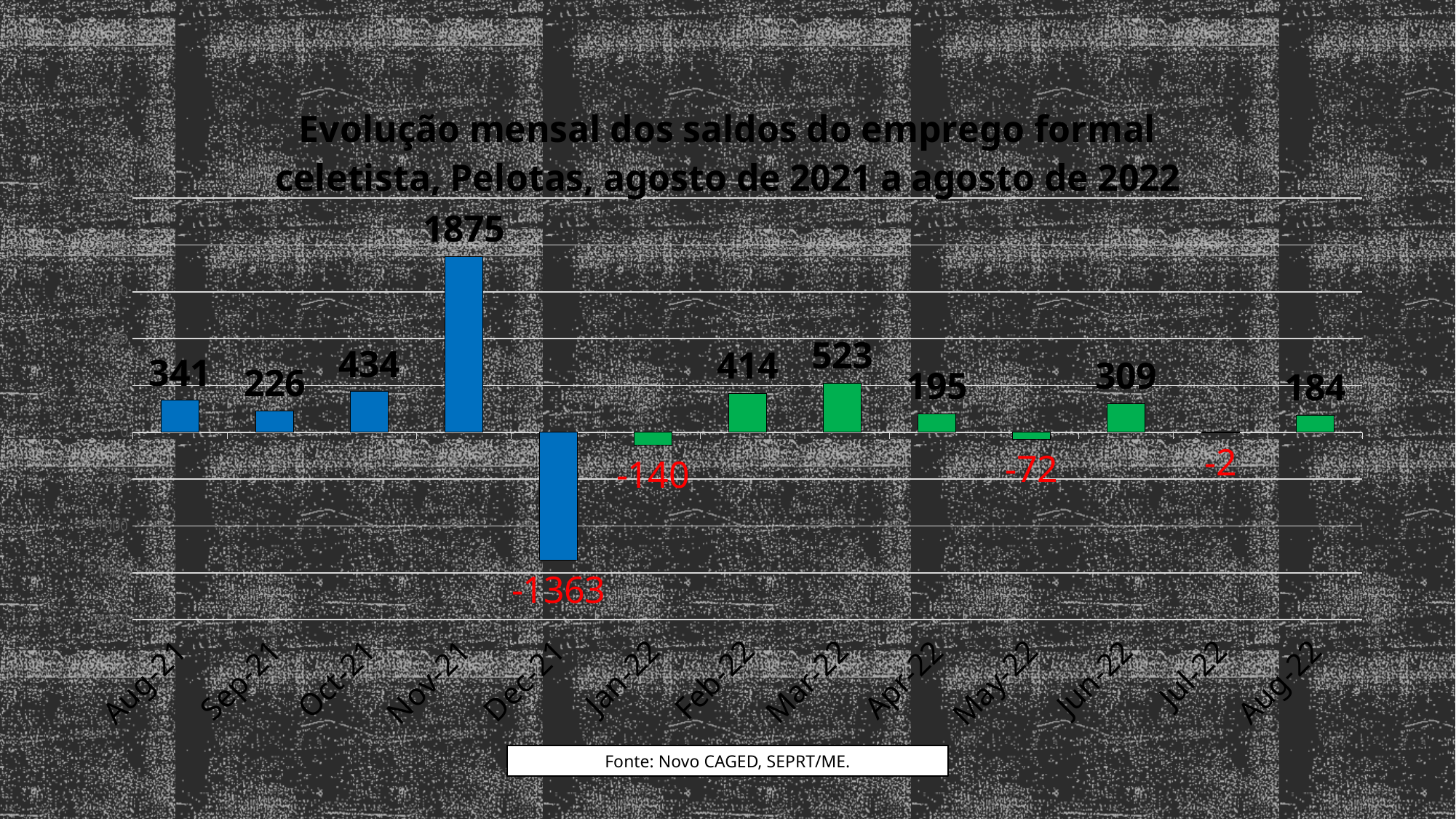
Which month has the lowest value? Dec-21 What is the difference between the values for Oct-21 and Sep-21? 208 How many months have a negative value? 4 What is the value for Jul-22? -2 What is the value for Nov-21? 1875 Which month has the highest value? Nov-21 What is the value for Dec-21? -1363 Which is larger, the value for Feb-22 or the value for Jun-22? Feb-22 What is the value for Mar-22? 523 What kind of chart is this? Bar chart What source is cited below the chart? Fonte: Novo CAGED, SEPRT/ME. How many months are shown on the x axis? 13